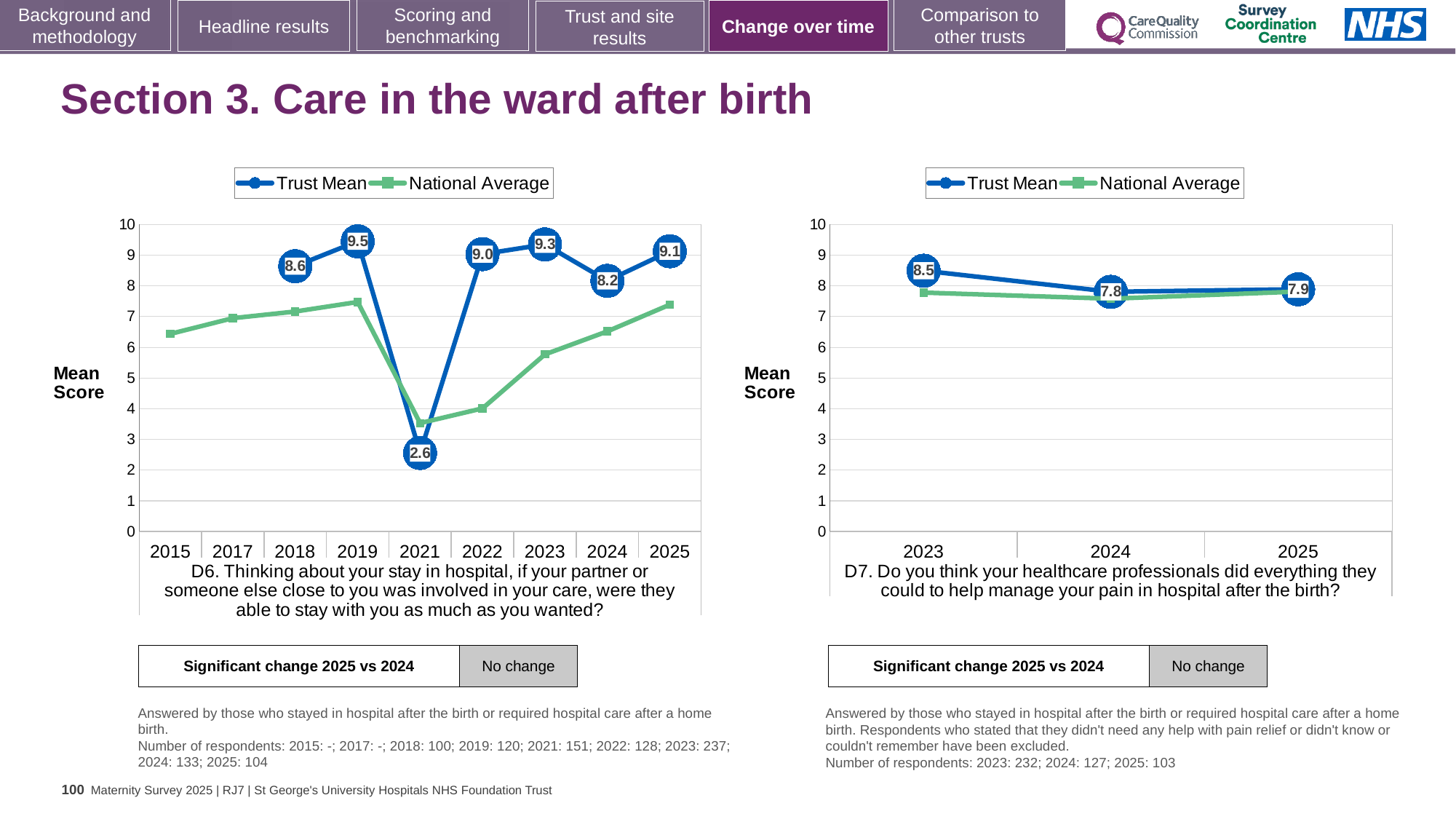
In the D6 chart on the left, how many years are shown on the x axis? 9 In the D6 chart on the left, is the National Average for 2015 greater or less than 7? less In the D6 chart on the left, what is the Trust Mean for 2021? 2.6 In the D7 chart on the right, what is the Trust Mean for 2023? 8.5 In the D6 chart on the left, which year has the lowest Trust Mean? 2021 In the D6 chart on the left, what is the difference between the Trust Mean for 2023 and 2024? 1.1 In the D7 chart on the right, what is the difference between the Trust Mean for 2023 and 2024? 0.7 In the D7 chart on the right, how many series does the legend list? 2 In the D7 chart on the right, which is larger, the Trust Mean for 2024 or for 2025? 2025 In the D6 chart on the left, which year has the highest Trust Mean? 2019 In the D6 chart on the left, what is the Trust Mean for 2025? 9.1 What kind of chart is the D7 chart on the right? Line chart